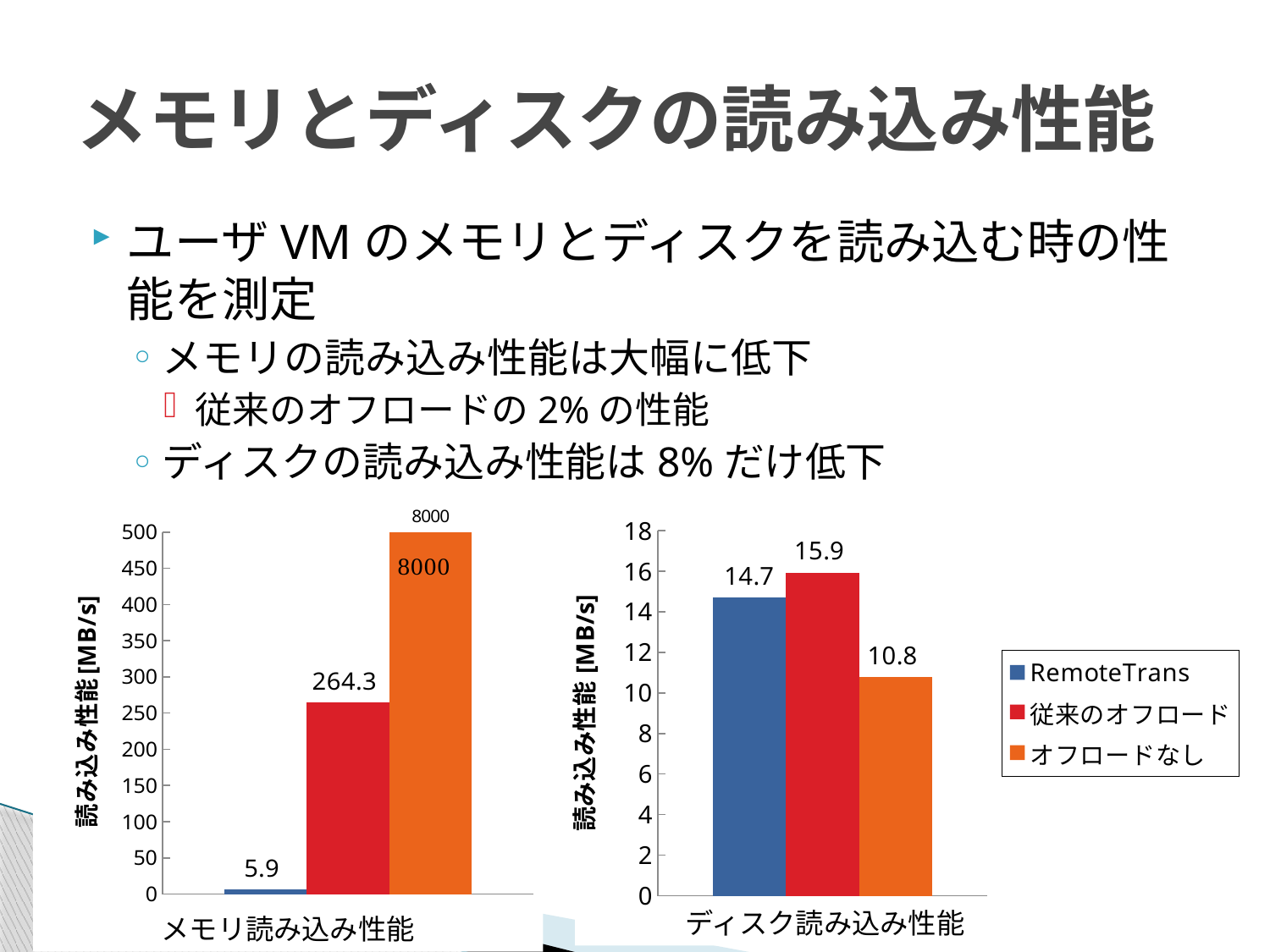
In the left chart (メモリ読み込み性能), what is the value for RemoteTrans? 5.9 In the right chart (ディスク読み込み性能), what is the difference between 従来のオフロード and RemoteTrans? 1.2 How many series does the legend list? 3 In the left chart (メモリ読み込み性能), what value is labelled on the オフロードなし bar? 8000 In the right chart (ディスク読み込み性能), which series has the highest value? 従来のオフロード In the left chart (メモリ読み込み性能), what is the value for 従来のオフロード? 264.3 What is the y-axis label of the left chart (メモリ読み込み性能)? 読み込み性能 [MB/s] In the right chart (ディスク読み込み性能), what is the value for オフロードなし? 10.8 In the right chart (ディスク読み込み性能), which series has the lowest value? オフロードなし In the right chart (ディスク読み込み性能), what is the value for RemoteTrans? 14.7 What kind of chart is the right chart (ディスク読み込み性能)? Bar chart In the left chart (メモリ読み込み性能), which is larger, the value for RemoteTrans or the value for 従来のオフロード? 従来のオフロード